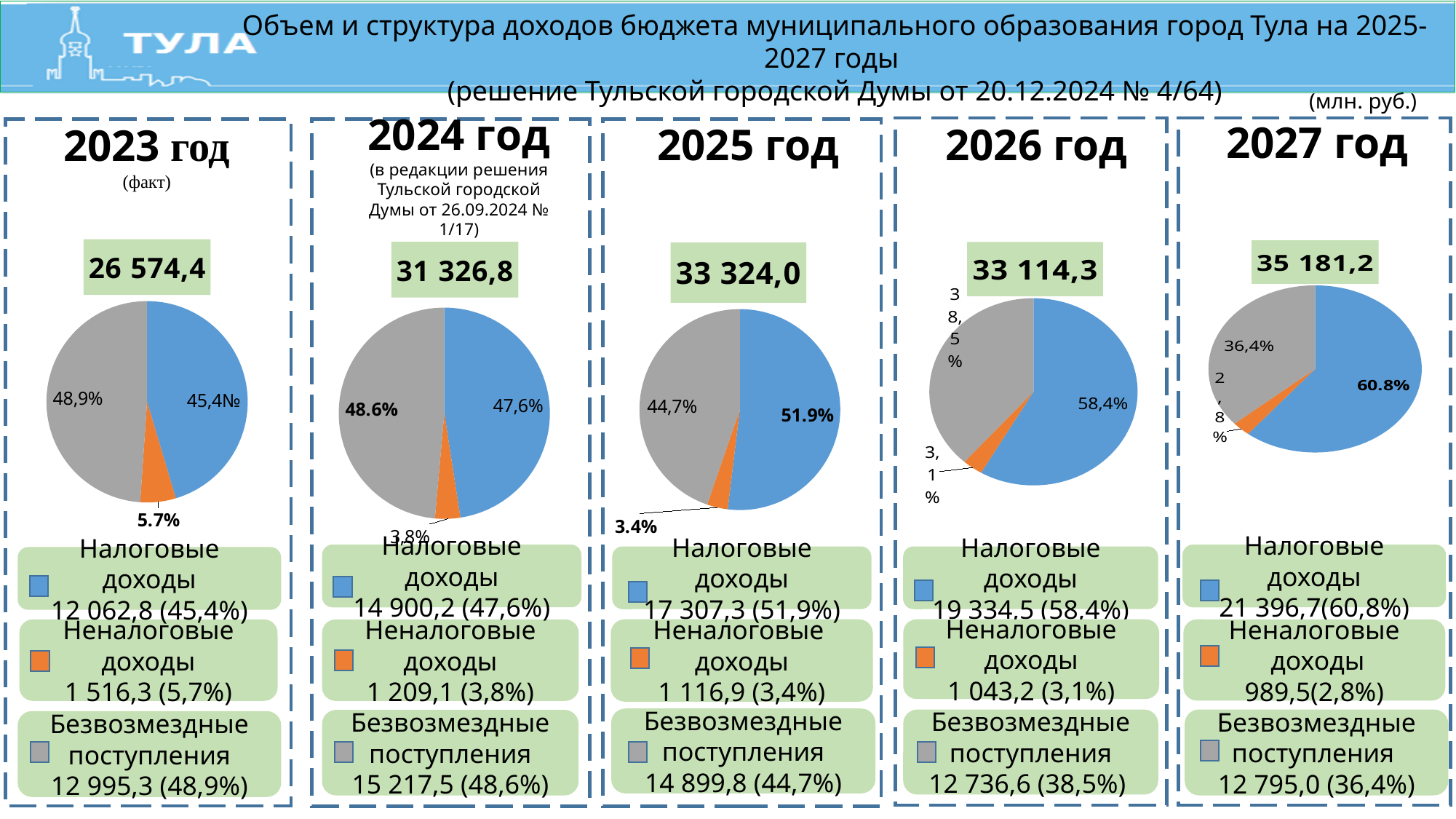
How many slices does each pie chart on the slide have? 3 In the 2027 год pie chart, which category has the largest share? Налоговые доходы In the 2024 год pie chart, which category has the smallest share? Неналоговые доходы In the 2023 год pie chart, what is the value of Безвозмездные поступления? 12 995,3 Which colour represents Неналоговые доходы in the pie charts? Orange In the 2027 год pie chart, what is the difference between Налоговые доходы and Безвозмездные поступления? 8 601,7 In the 2025 год pie chart, what share do Налоговые доходы make up? 51,9% How many pie charts are shown on the slide? 5 In the 2026 год pie chart, what is the value of Неналоговые доходы? 1 043,2 What type of chart is used for each year on the slide? Pie chart What is the total budget income shown above the 2025 год pie chart? 33 324,0 In the 2026 год pie chart, which is larger: Налоговые доходы or Безвозмездные поступления? Налоговые доходы